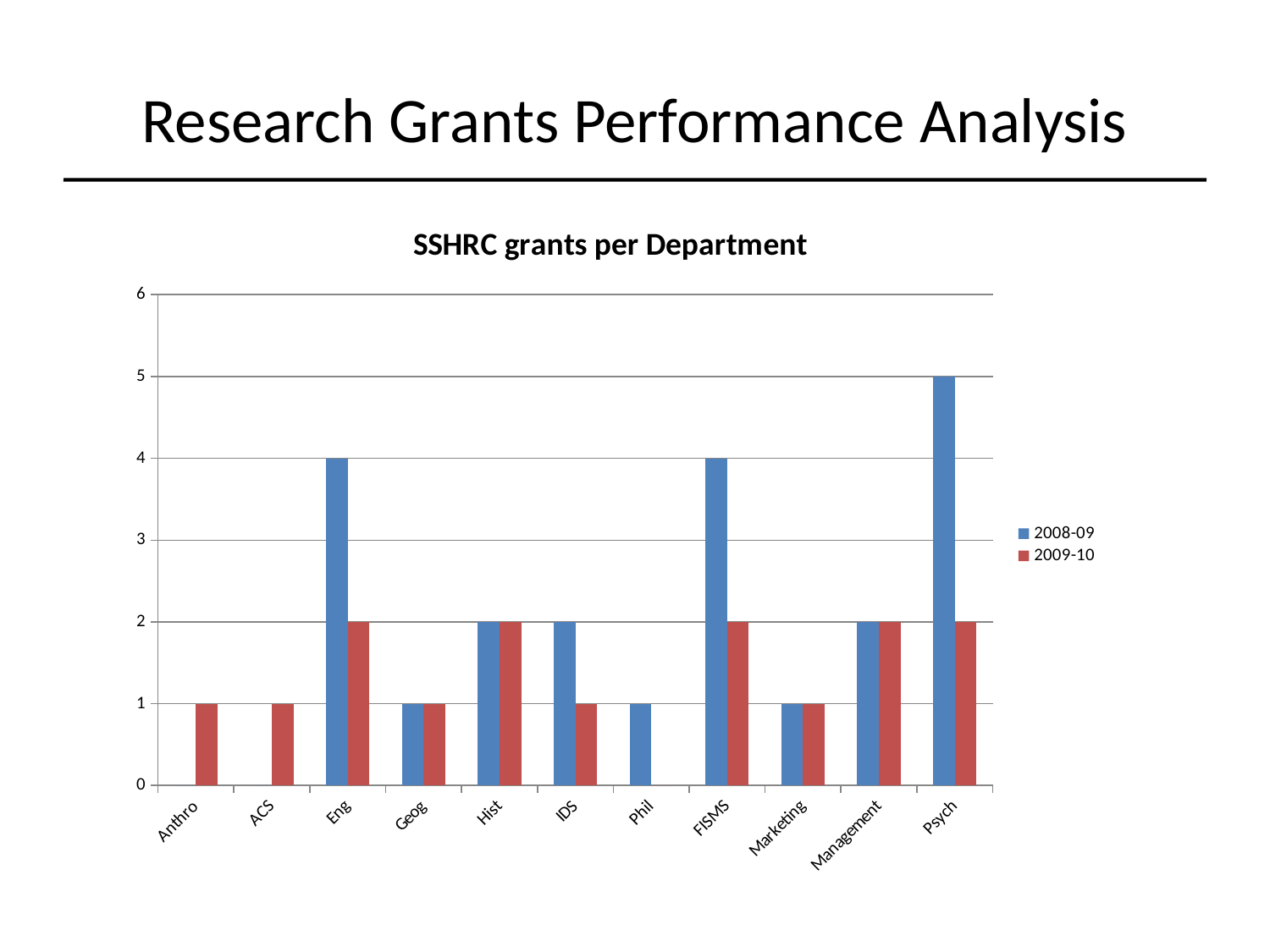
Which colour represents the 2009-10 series? red What type of chart is shown on the slide? bar chart What is the 2009-10 value for Anthro? 1 Which department has the highest 2008-09 value? Psych Is the 2008-09 value for Eng greater or less than 3? greater How many series does the legend list? 2 How many departments are shown on the x axis? 11 What is the title of the chart? SSHRC grants per Department Which is larger for IDS, the 2008-09 value or the 2009-10 value? 2008-09 What is the difference between the 2008-09 and 2009-10 values for FISMS? 2 What is the 2009-10 value for Eng? 2 What is the 2008-09 value for Psych? 5